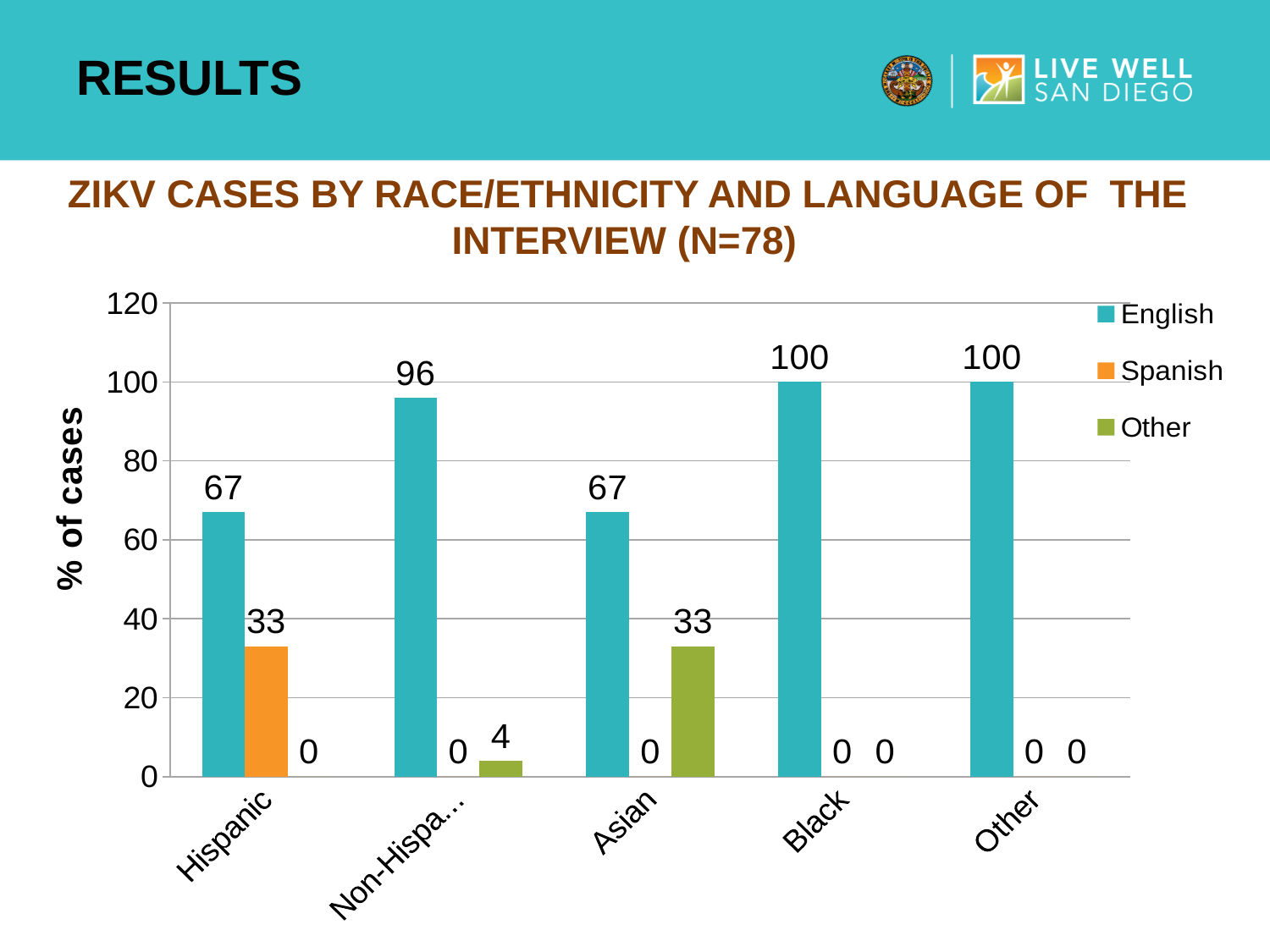
Which category has the lowest English value? Hispanic and Asian Which is larger, the English value for Hispanic or the Spanish value for Hispanic? English What is the y-axis label? % of cases What is the Spanish value for Hispanic? 33 How many series does the legend list? 3 What is the English value for Black? 100 What is the English value for Hispanic? 67 What kind of chart is this? Bar chart What is the English value for Asian? 67 How many categories are shown on the x axis? 5 What is the difference between the English value for Black and the English value for Hispanic? 33 What is the Other value for Asian? 33